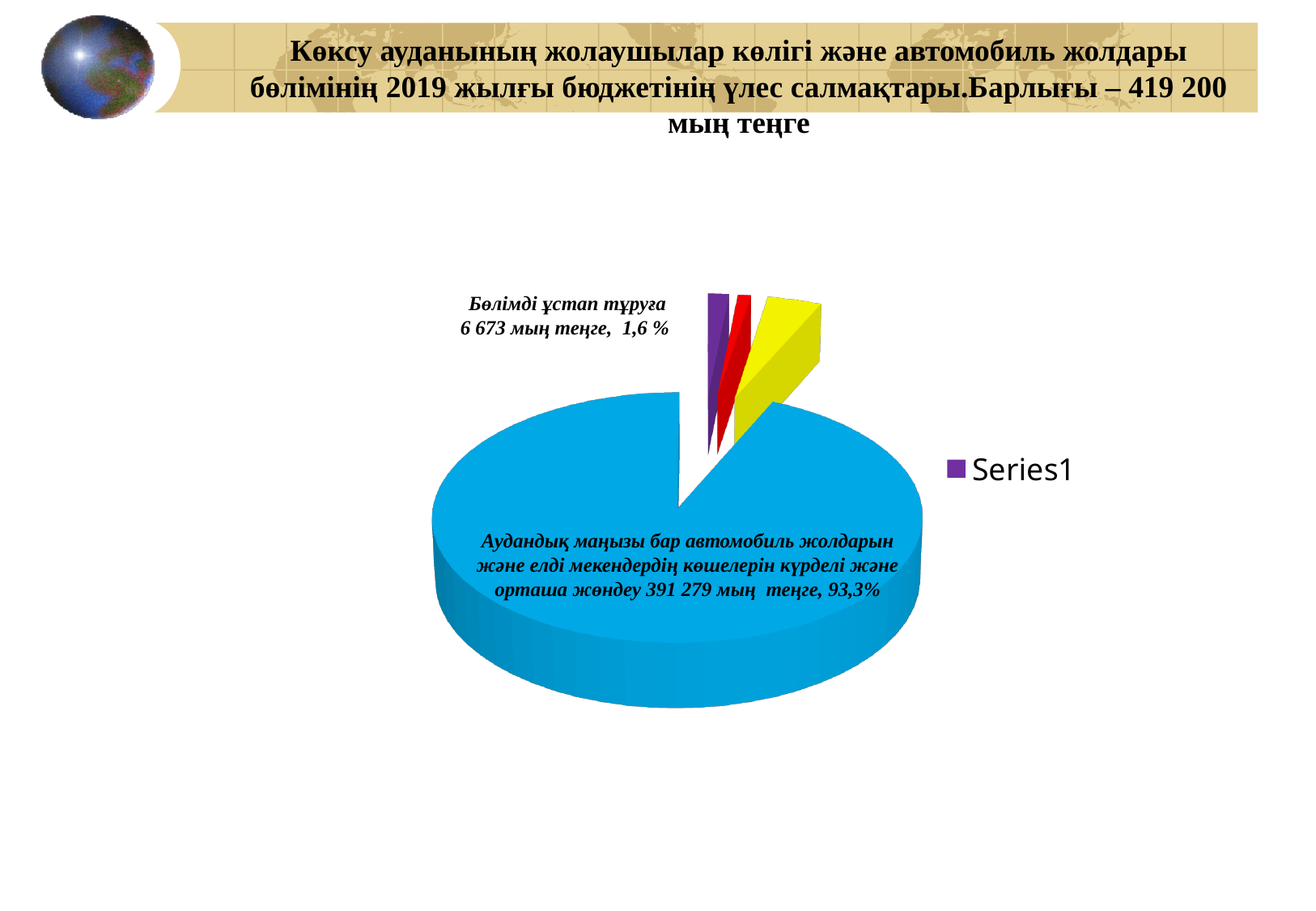
What colour is the largest slice of the pie? Blue Which is larger: the value for 'Бөлімді ұстап тұруға' or the value for 'Аудандық маңызы бар автомобиль жолдарын және елді мекендердің көшелерін күрделі және орташа жөндеу'? Аудандық маңызы бар автомобиль жолдарын және елді мекендердің көшелерін күрделі және орташа жөндеу What share of the pie is labelled for 'Бөлімді ұстап тұруға'? 1,6 % What is the difference between the value for 'Аудандық маңызы бар автомобиль жолдарын және елді мекендердің көшелерін күрделі және орташа жөндеу' and the value for 'Бөлімді ұстап тұруға'? 384 606 мың теңге What type of chart is shown on the slide? Pie chart What is the value labelled for 'Бөлімді ұстап тұруға'? 6 673 мың теңге What entry is shown in the chart legend? Series1 How many series does the legend list? 1 How many slices does the pie chart have? 4 Which labelled category has the largest slice of the pie? Аудандық маңызы бар автомобиль жолдарын және елді мекендердің көшелерін күрделі және орташа жөндеу What share of the pie is labelled for 'Аудандық маңызы бар автомобиль жолдарын және елді мекендердің көшелерін күрделі және орташа жөндеу'? 93,3% What is the value labelled for 'Аудандық маңызы бар автомобиль жолдарын және елді мекендердің көшелерін күрделі және орташа жөндеу'? 391 279 мың теңге